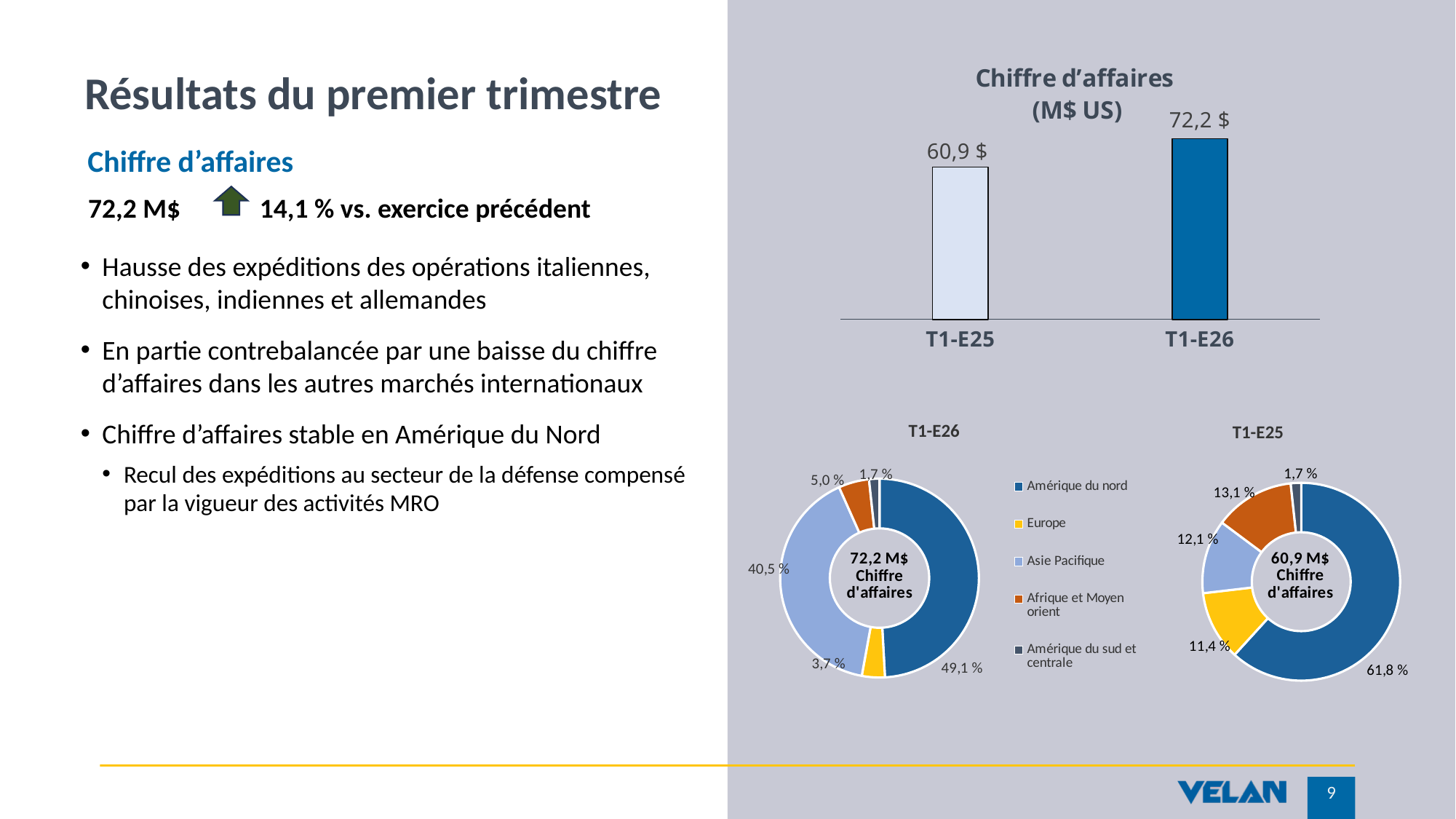
In the T1-E25 donut chart, what share does Afrique et Moyen orient represent? 13,1 % In the T1-E25 donut chart, which region has the largest share? Amérique du nord How many regions does the legend of the donut charts list? 5 In the bar chart 'Chiffre d'affaires (M$ US)', what is the value for T1-E25? 60,9 $ In the T1-E26 donut chart, which region has the smallest share? Amérique du sud et centrale In the T1-E26 donut chart, what share does Asie Pacifique represent? 40,5 % What kind of chart is the 'Chiffre d'affaires (M$ US)' chart at the top right? Bar chart In the bar chart 'Chiffre d'affaires (M$ US)', what is the value for T1-E26? 72,2 $ In the bar chart 'Chiffre d'affaires (M$ US)', which period has the higher value? T1-E26 In the bar chart 'Chiffre d'affaires (M$ US)', what is the difference between the T1-E26 and T1-E25 values? 11,3 $ In the T1-E26 donut chart, what share does Europe represent? 3,7 % What is the difference between the Amérique du nord share in the T1-E25 donut chart and in the T1-E26 donut chart? 12,7 %